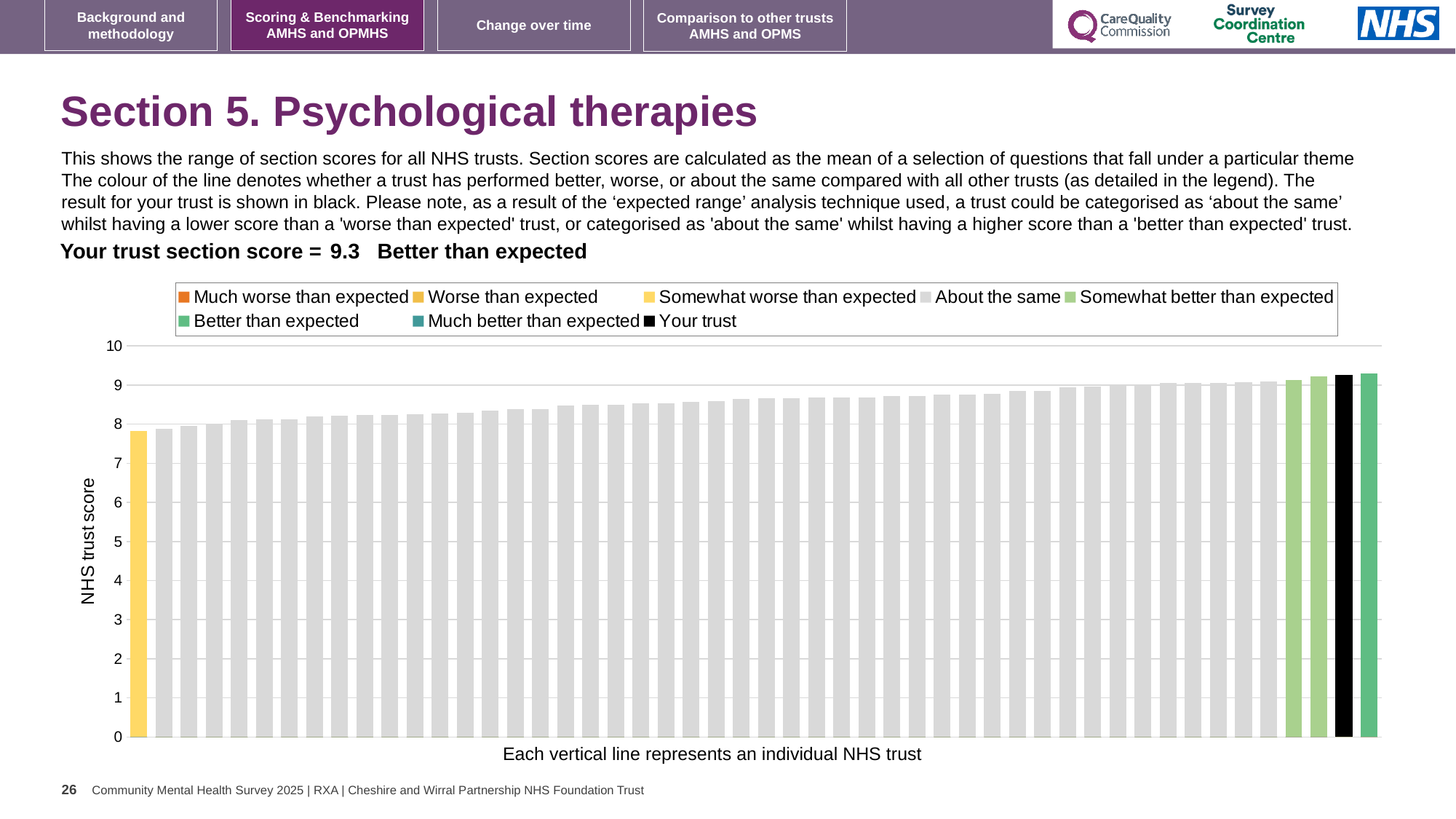
Do the bar values rise or fall from left to right along the x axis? rise Which bar has the lowest value, the leftmost or the rightmost? leftmost What is the highest value shown on the vertical axis? 10 How many entries does the chart legend list? 8 What is the label on the vertical axis of the chart? NHS trust score What is the label below the horizontal axis of the chart? Each vertical line represents an individual NHS trust Which category is your trust's section score placed in? Better than expected Is the value of the leftmost bar greater or less than 7? greater What kind of chart is shown on the slide? bar chart Is the value of the black 'Your trust' bar greater or less than 9? greater What is the section score for your trust shown on the slide? 9.3 Is the value of the leftmost bar greater or less than 9? less